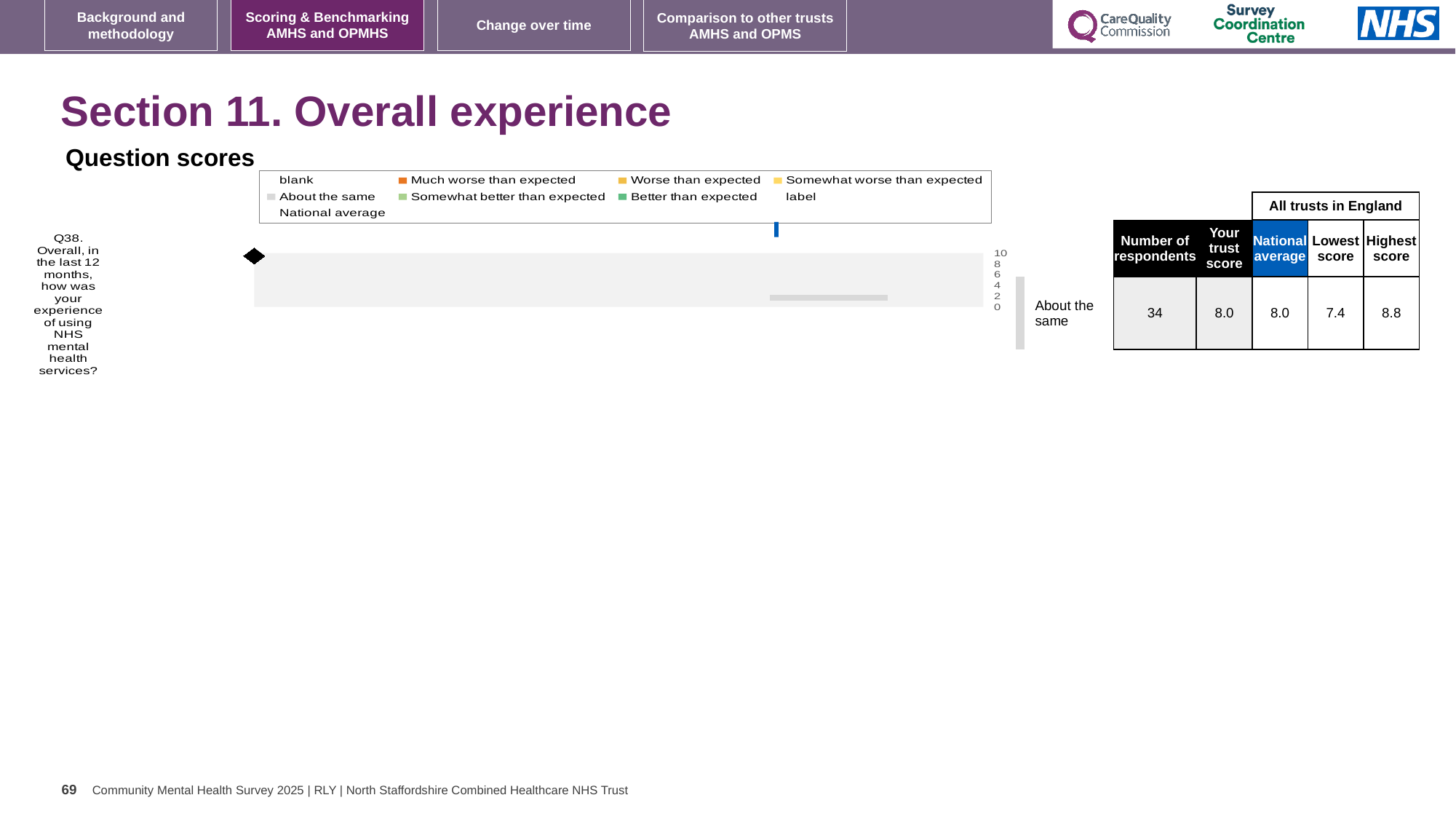
What is the highest score among all trusts in England for Q38? 8.8 What is the difference between the highest score and the lowest score for Q38? 1.4 Which question is plotted in the Question scores chart? Q38. Overall, in the last 12 months, how was your experience of using NHS mental health services? What is the trust score for Q38? 8.0 How many questions are plotted in the Question scores chart? 1 How many respondents answered Q38? 34 Is the trust score for Q38 greater or less than 6? greater Which benchmark category is Q38 placed in? About the same What is the national average score for Q38? 8.0 What kind of chart is shown under 'Question scores'? bar chart What is the difference between the highest score and the trust score for Q38? 0.8 What is the lowest score among all trusts in England for Q38? 7.4